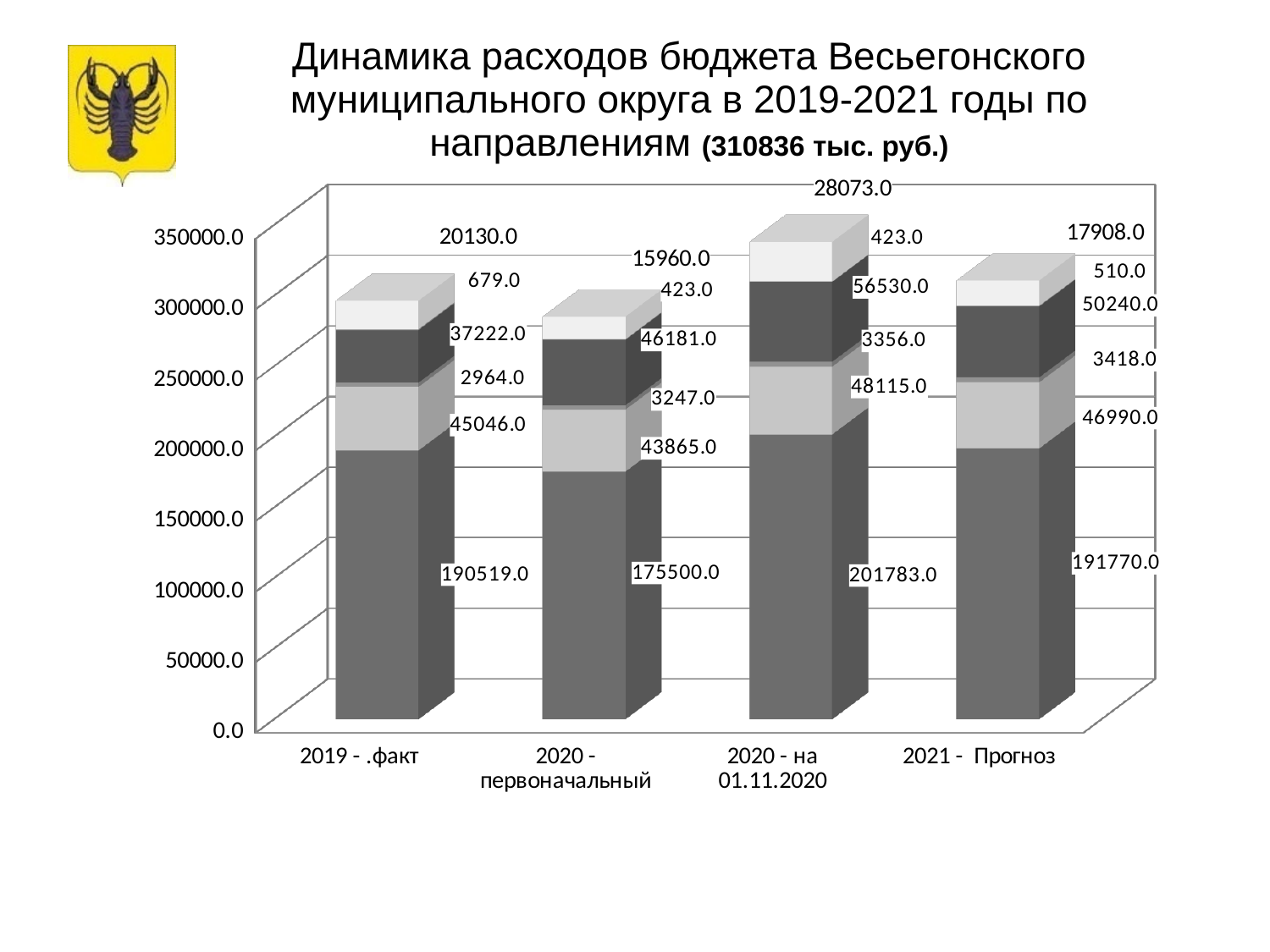
What is the total of the stacked bar for '2021 - Прогноз'? 310836.0 What is the value of the bottom segment for '2020 - на 01.11.2020'? 201783.0 How many categories (bars) are shown along the x axis? 4 Which is larger: the top segment for '2019 - .факт' or the top segment for '2020 - первоначальный'? 2019 - .факт What is the difference between the bottom segment values for '2020 - на 01.11.2020' and '2020 - первоначальный'? 26283.0 What total amount in thousand rubles is given in parentheses in the chart title? 310836 тыс. руб. What is the value of the top segment for '2021 - Прогноз'? 17908.0 What type of chart is shown on the slide? stacked bar chart Is the total height of the bar for '2020 - на 01.11.2020' greater or less than 300000.0? greater Which category has the highest value for the bottom segment? 2020 - на 01.11.2020 Which category has the lowest value for the bottom segment? 2020 - первоначальный What is the value of the bottom (largest) segment for '2019 - .факт'? 190519.0